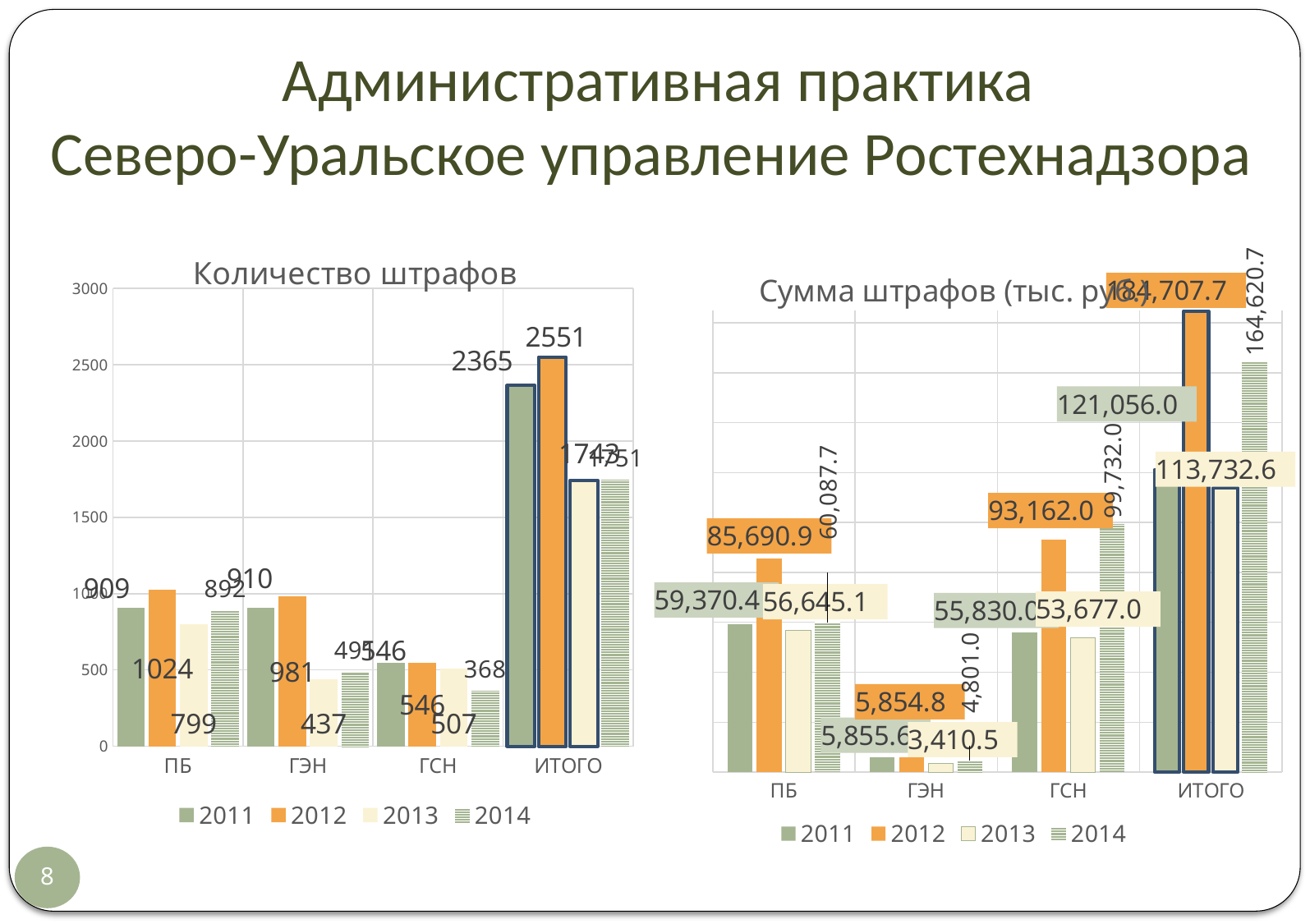
In the chart 'Количество штрафов', what is the value for ГЭН in 2013? 437 In the chart 'Сумма штрафов (тыс. руб.)', what is the difference between the 2012 and 2011 values for ИТОГО? 63,651.7 How many series does the legend of the chart 'Количество штрафов' list? 4 In the chart 'Количество штрафов', what is the value for ИТОГО in 2011? 2365 In the chart 'Сумма штрафов (тыс. руб.)', what is the value for ИТОГО in 2013? 113,732.6 In the chart 'Количество штрафов', what is the difference between the 2012 and 2011 values for ИТОГО? 186 In the chart 'Сумма штрафов (тыс. руб.)', which category and year has the lowest value? ГЭН, 2013 (3,410.5) In the chart 'Количество штрафов', which category has the lowest value for 2014? ГСН In the chart 'Сумма штрафов (тыс. руб.)', what is the value for ГСН in 2014? 99,732.0 In the chart 'Сумма штрафов (тыс. руб.)', which is larger for ГСН: the 2012 value or the 2014 value? 2014 What type of chart is 'Сумма штрафов (тыс. руб.)'? Bar chart In the chart 'Количество штрафов', what is the value for ПБ in 2012? 1024